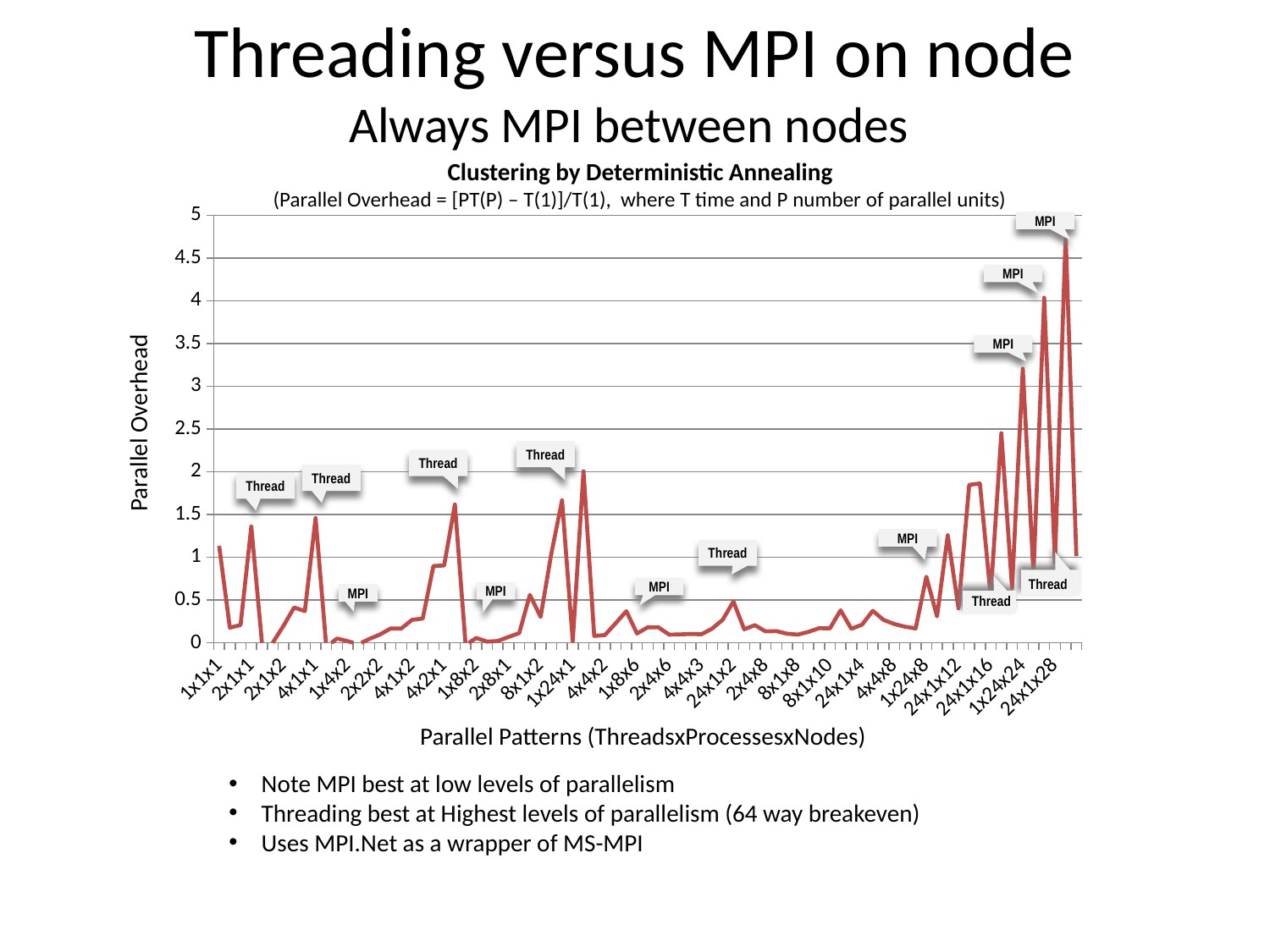
Is the value for 8x1x8 greater or less than 0.5? less Which is larger, the value for 24x1x12 or the value for 2x4x8? 24x1x12 Is the value for 2x4x6 greater or less than 0.5? less Is the value for 1x24x24 greater or less than 3.5? less What is the label of the x axis of the chart? Parallel Patterns (ThreadsxProcessesxNodes) What is the title of the chart? Clustering by Deterministic Annealing What kind of chart is shown on the slide? line chart